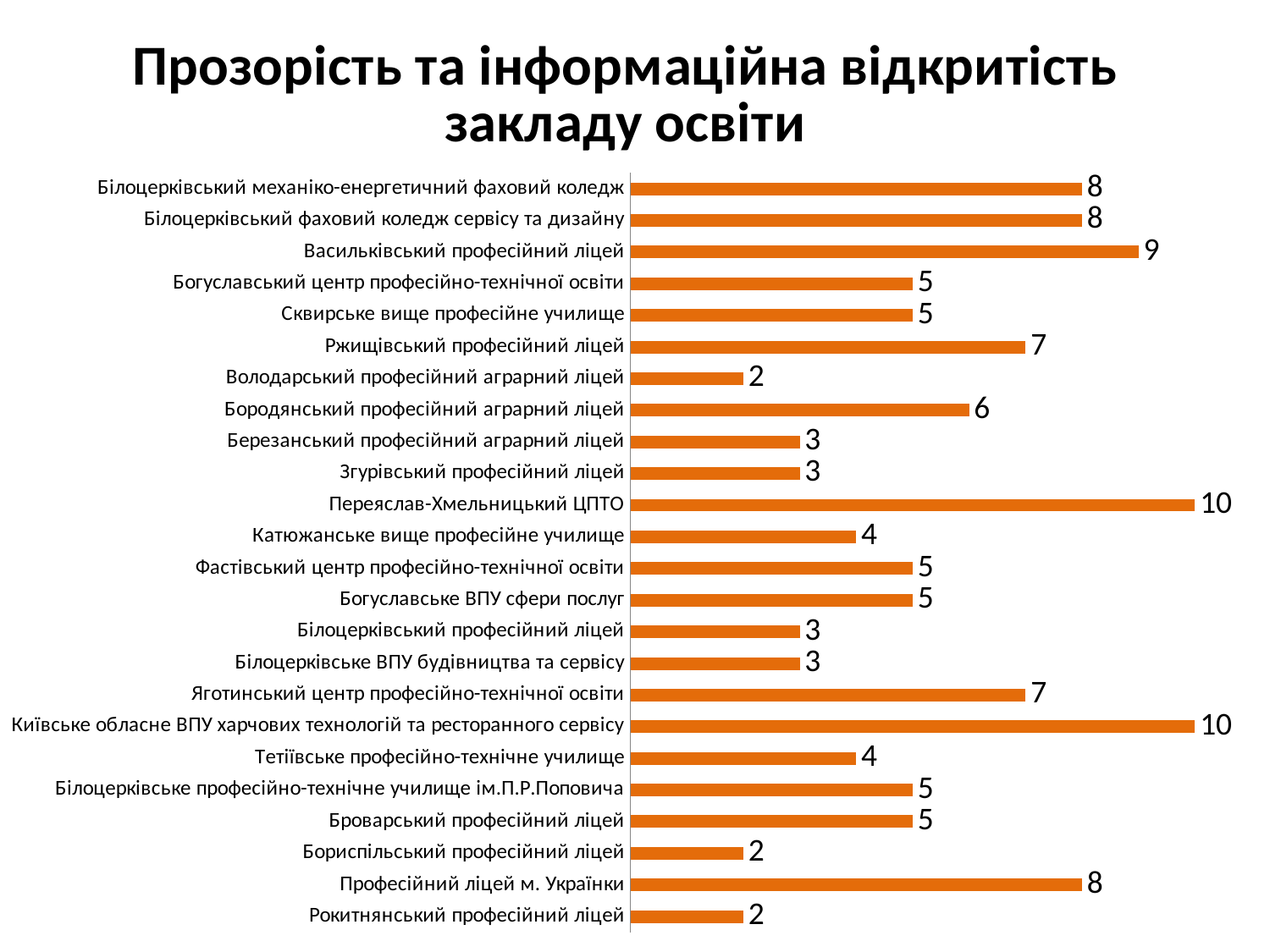
What is the value for Володарський професійний аграрний ліцей? 2 What is the title of the chart? Прозорість та інформаційна відкритість закладу освіти What is the difference between the values for Ржищівський професійний ліцей and Згурівський професійний ліцей? 4 Which has a larger value: Катюжанське вище професійне училище or Богуславське ВПУ сфери послуг? Богуславське ВПУ сфери послуг What is the value for Професійний ліцей м. Українки? 8 What is the value for Васильківський професійний ліцей? 9 What kind of chart is shown on the slide? Bar chart What is the highest value shown on the chart? 10 What is the value for Переяслав-Хмельницький ЦПТО? 10 What is the value for Бородянський професійний аграрний ліцей? 6 What is the lowest value shown on the chart? 2 How many categories (institutions) are shown on the chart? 24